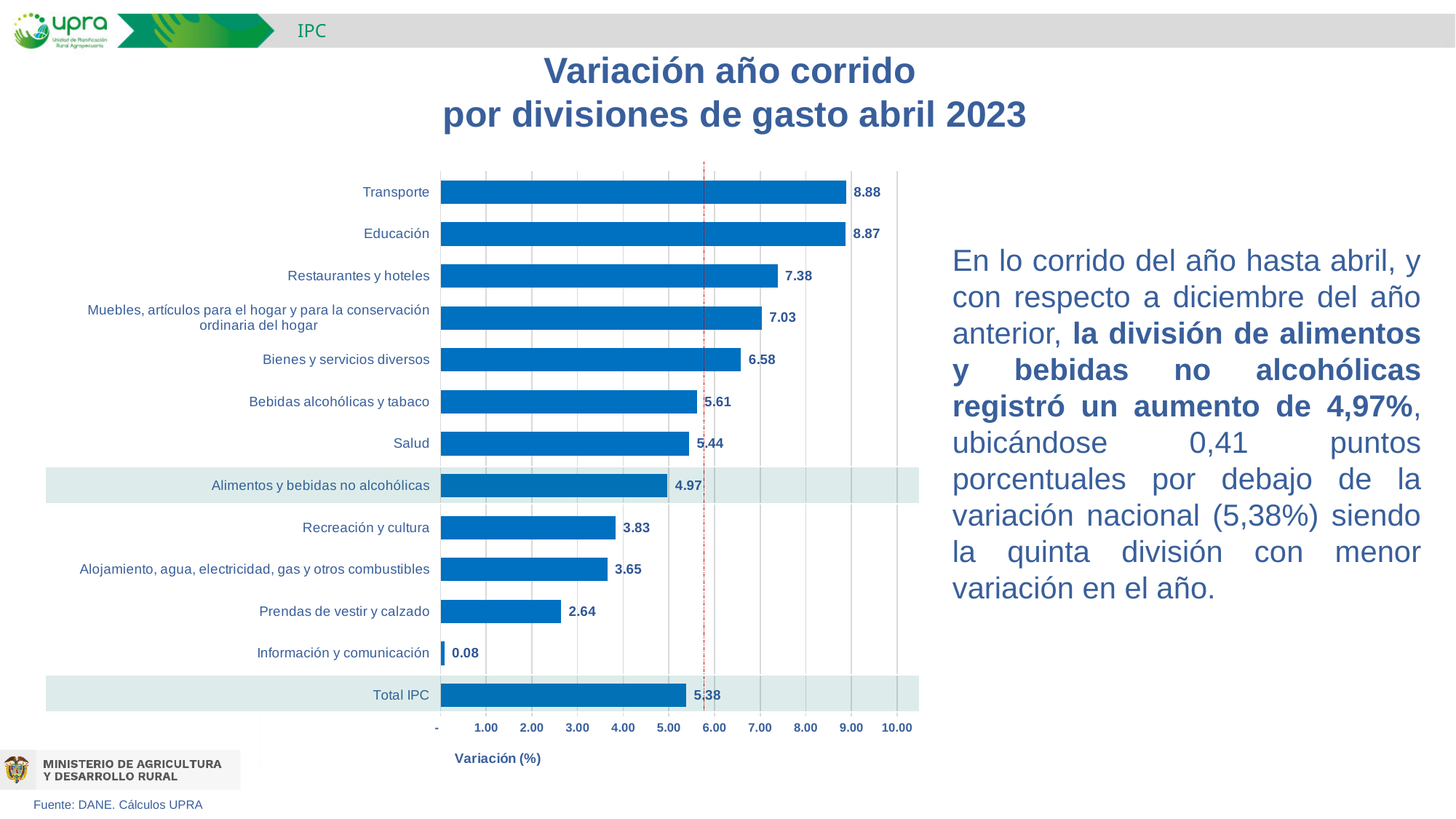
How many bars are shown in the chart? 13 Which is larger, the value for Bienes y servicios diversos or the value for Salud? Bienes y servicios diversos Which category has the lowest value? Información y comunicación What is the value for Transporte? 8.88 What is the value for Total IPC? 5.38 What is the value for Prendas de vestir y calzado? 2.64 What is the difference between the value for Transporte and the value for Restaurantes y hoteles? 1.50 What is the value for Alimentos y bebidas no alcohólicas? 4.97 What is the difference between the value for Total IPC and the value for Alimentos y bebidas no alcohólicas? 0.41 What kind of chart is shown on the slide? bar chart What is the title of the horizontal axis? Variación (%) Is the value for Recreación y cultura greater or less than 4.00? less